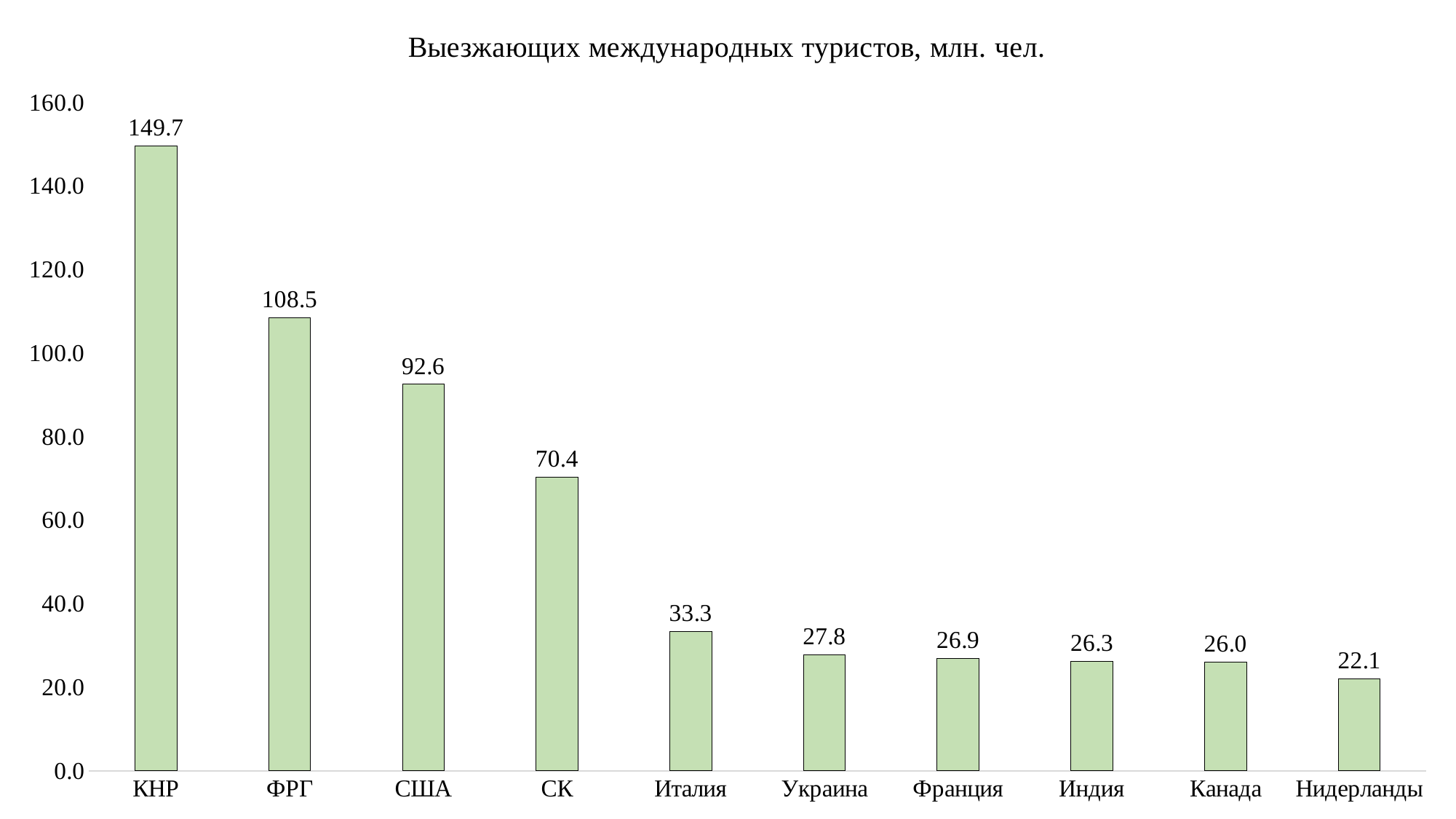
How many categories are shown on the x axis? 10 Which category has the highest value? КНР What is the difference between the values for ФРГ and США? 15.9 Which category has the lowest value? Нидерланды Do the values rise or fall from left to right along the x axis? fall Is the value for ФРГ greater or less than 100.0? greater What is the title of the chart? Выезжающих международных туристов, млн. чел. What is the value for КНР? 149.7 What kind of chart is this? bar chart What is the value for Италия? 33.3 What is the value for Нидерланды? 22.1 Which is larger, the value for СК or the value for Италия? СК